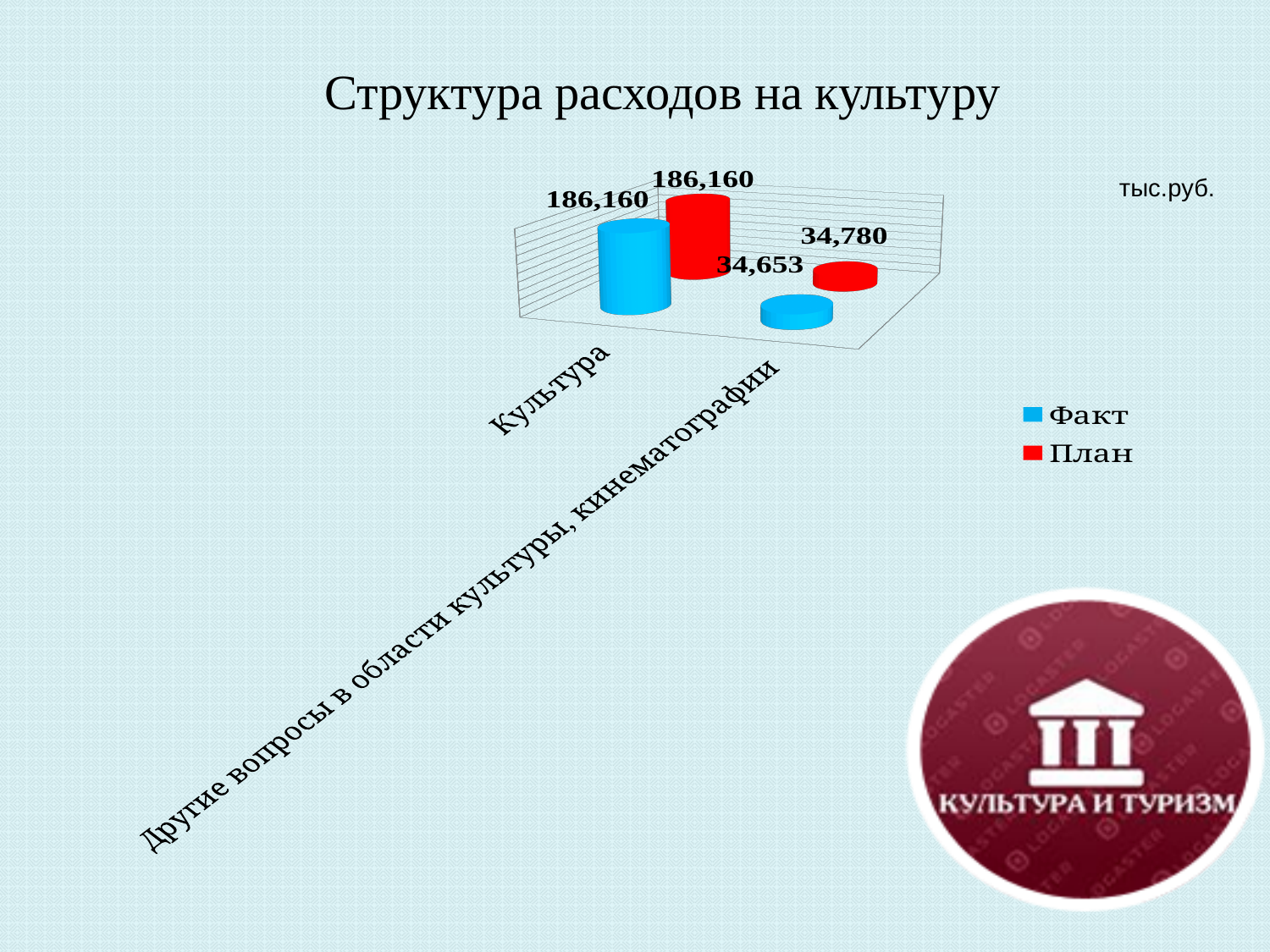
How many series does the legend list? 2 Which category has the higher Факт value? Культура What is the title of the chart? Структура расходов на культуру What is the difference between the План and Факт values for Другие вопросы в области культуры, кинематографии? 127 What is the План value for Культура? 186,160 What is the План value for Другие вопросы в области культуры, кинематографии? 34,780 What is the difference between the Факт values for Культура and Другие вопросы в области культуры, кинематографии? 151,507 What is the Факт value for Культура? 186,160 What is the Факт value for Другие вопросы в области культуры, кинематографии? 34,653 How many categories are shown on the chart? 2 Which category has the lowest План value? Другие вопросы в области культуры, кинематографии What kind of chart is shown on the slide? Bar chart